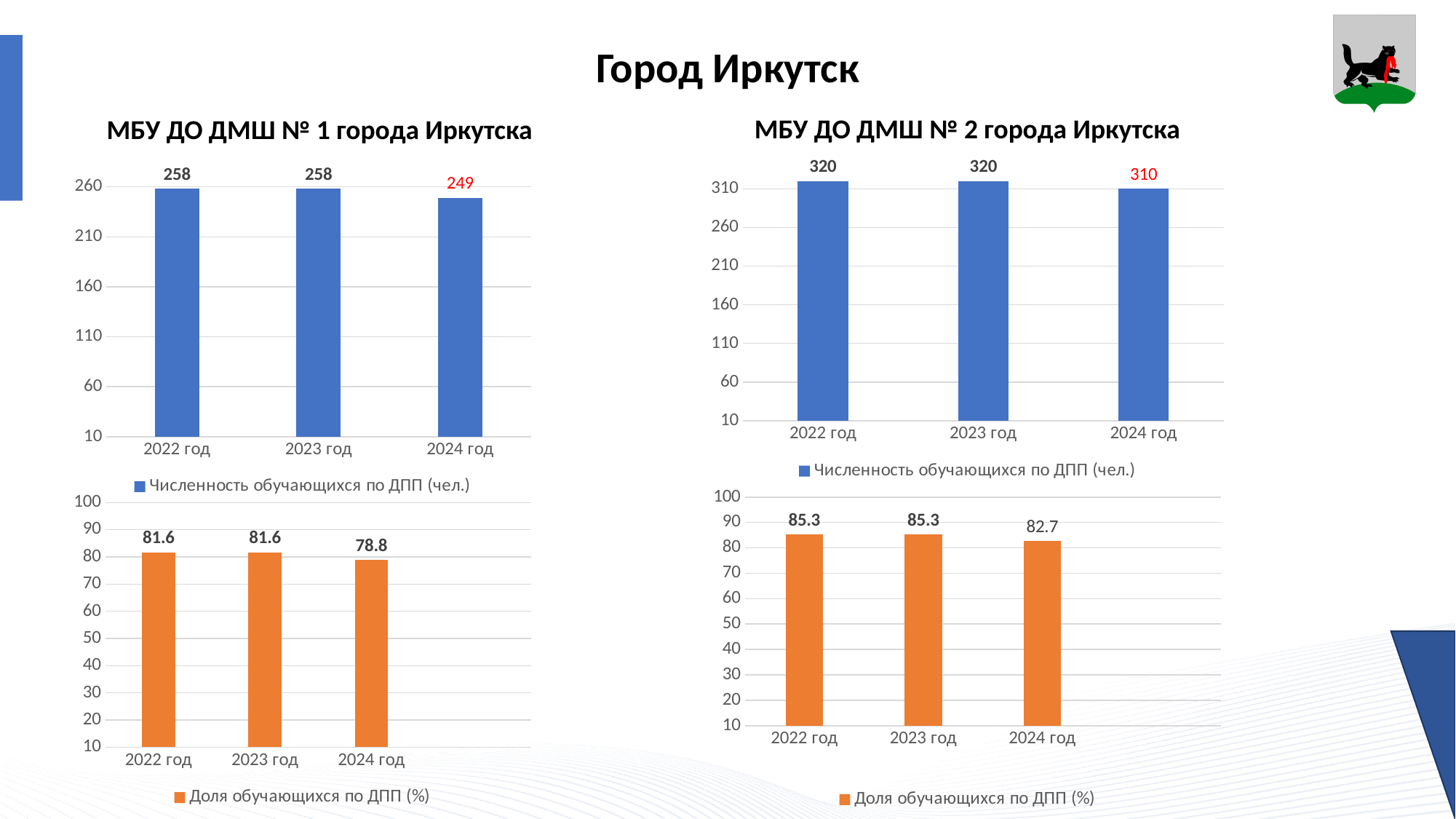
In the top-right chart (ДМШ № 2, Численность обучающихся по ДПП), what is the difference between the 2023 год and 2024 год values? 10 In the top-left chart (ДМШ № 1, Численность обучающихся по ДПП), which year has the lowest value? 2024 год In the bottom-right chart (ДМШ № 2, Доля обучающихся по ДПП), which is larger: the value for 2022 год or 2024 год? 2022 год What is the legend entry of the top-left chart under the title МБУ ДО ДМШ № 1 города Иркутска? Численность обучающихся по ДПП (чел.) How many years are shown on the x axis of the top-right chart (ДМШ № 2, Численность обучающихся по ДПП)? 3 In the bottom-left chart (ДМШ № 1, Доля обучающихся по ДПП), do the values rise or fall from 2023 год to 2024 год? fall In the bottom-right chart (ДМШ № 2, Доля обучающихся по ДПП), what is the value for 2023 год? 85.3 What kind of chart is the bottom-left chart (ДМШ № 1, Доля обучающихся по ДПП)? bar chart In the top-left chart (МБУ ДО ДМШ № 1 города Иркутска, Численность обучающихся по ДПП), what is the value for 2024 год? 249 In the bottom-left chart (ДМШ № 1, Доля обучающихся по ДПП), what is the value for 2024 год? 78.8 In the top-right chart (МБУ ДО ДМШ № 2 города Иркутска, Численность обучающихся по ДПП), what is the value for 2022 год? 320 In the top-left chart (ДМШ № 1, Численность обучающихся по ДПП), what is the difference between the 2022 год and 2024 год values? 9